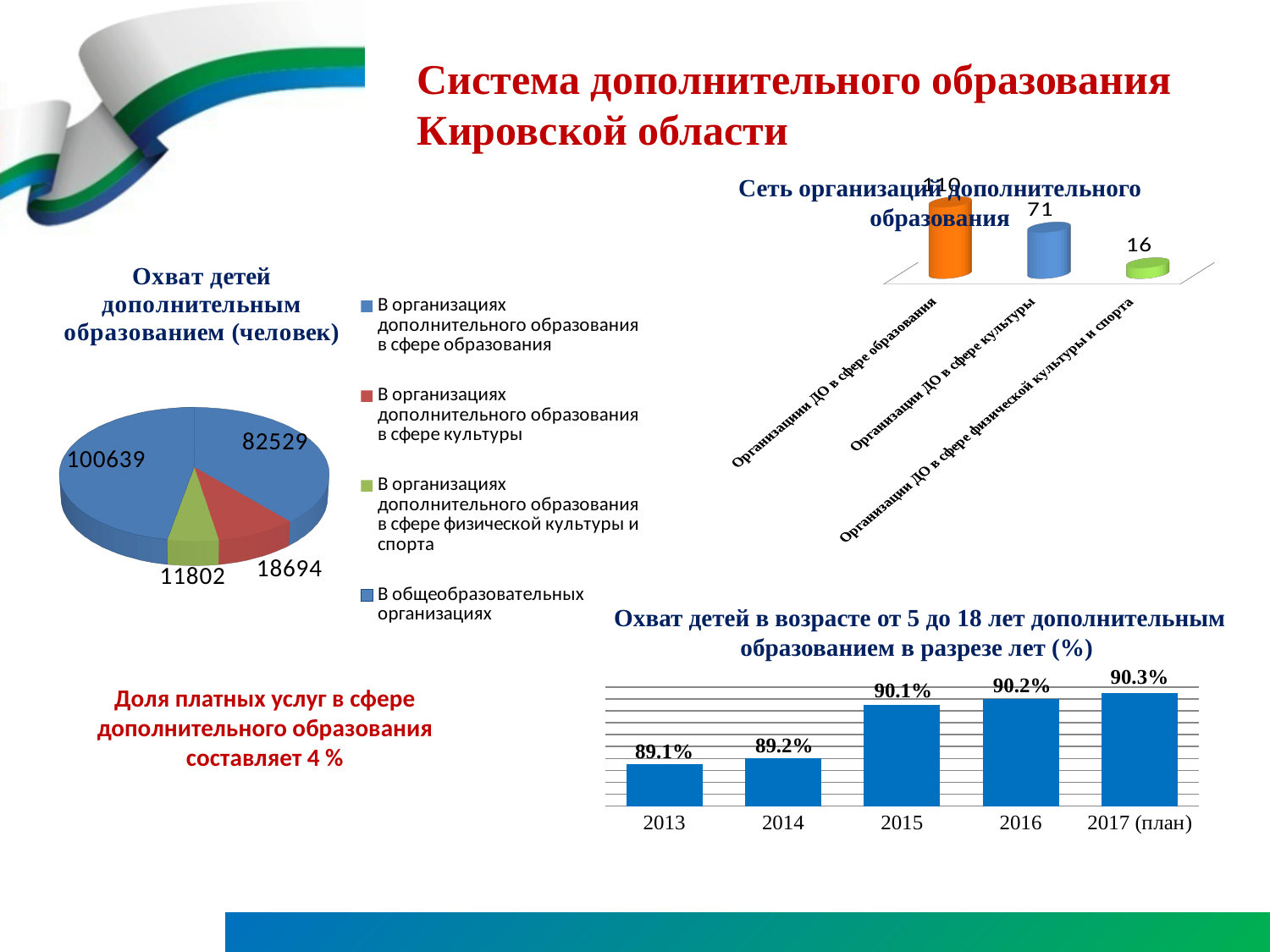
In the chart 'Сеть организаций дополнительного образования', what is the value for 'Организации ДО в сфере культуры'? 71 In the chart 'Охват детей в возрасте от 5 до 18 лет дополнительным образованием в разрезе лет (%)', what is the value for 2015? 90.1% In the chart 'Охват детей в возрасте от 5 до 18 лет дополнительным образованием в разрезе лет (%)', do the values rise or fall from 2013 to 2017 (план)? rise In the chart 'Сеть организаций дополнительного образования', which category has the highest value? Организации ДО в сфере образования In the chart 'Сеть организаций дополнительного образования', what is the value for 'Организации ДО в сфере физической культуры и спорта'? 16 In the pie chart 'Охват детей дополнительным образованием (человек)', what is the difference between the values 100639 and 82529? 18110 In the pie chart 'Охват детей дополнительным образованием (человек)', what is the value for 'В организациях дополнительного образования в сфере культуры'? 18694 In the pie chart 'Охват детей дополнительным образованием (человек)', what is the value for 'В организациях дополнительного образования в сфере физической культуры и спорта'? 11802 In the chart 'Охват детей в возрасте от 5 до 18 лет дополнительным образованием в разрезе лет (%)', how many years are shown on the x axis? 5 In the pie chart 'Охват детей дополнительным образованием (человек)', which category has the smallest value? В организациях дополнительного образования в сфере физической культуры и спорта In the pie chart 'Охват детей дополнительным образованием (человек)', how many entries does the legend list? 4 In the pie chart 'Охват детей дополнительным образованием (человек)', what is the value for 'В общеобразовательных организациях'? 100639